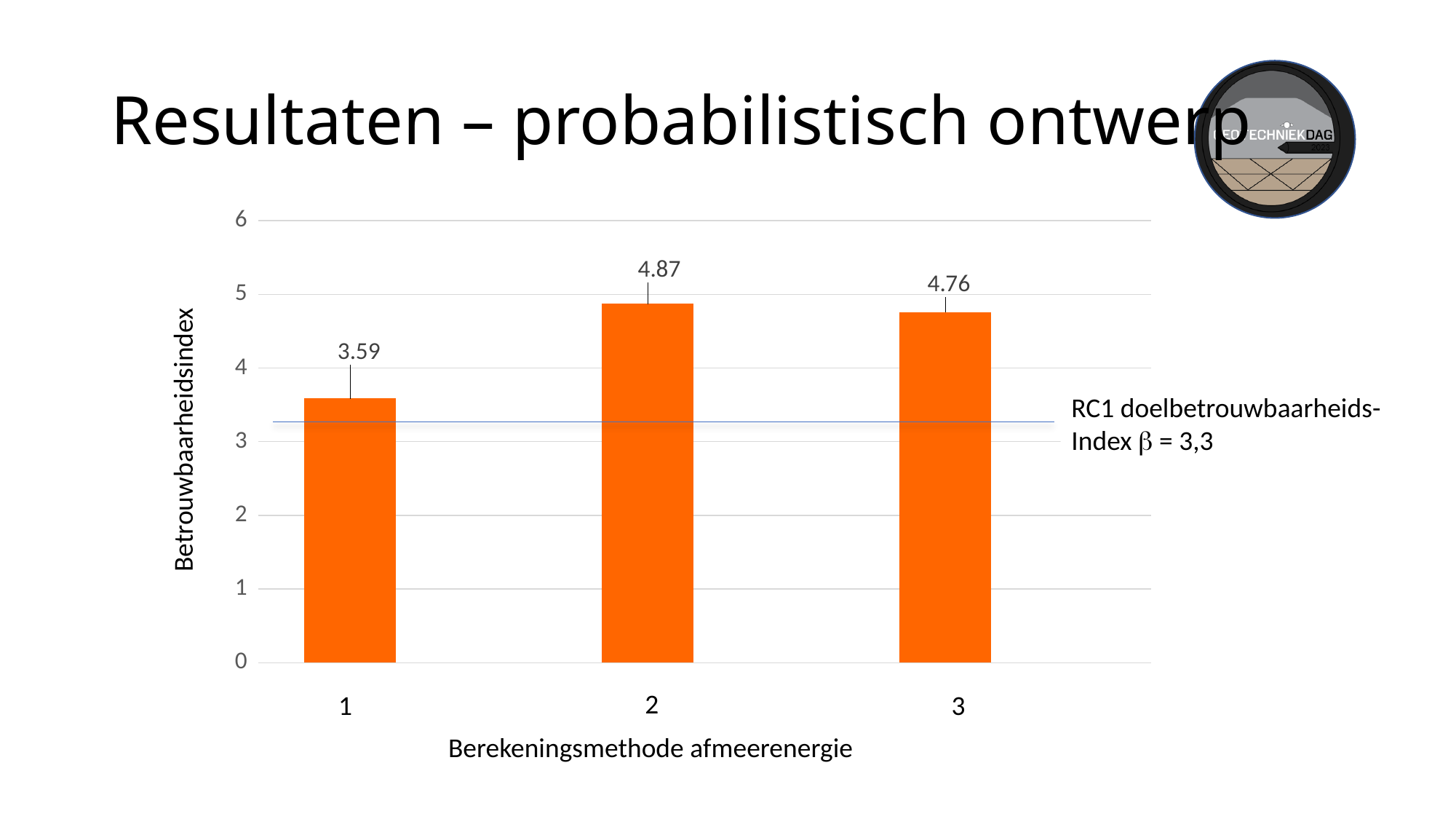
Which has a larger Betrouwbaarheidsindex, method 1 or method 3? 3 What is the difference between the Betrouwbaarheidsindex for method 2 and method 1? 1.28 What is the Betrouwbaarheidsindex for Berekeningsmethode 3? 4.76 How many Berekeningsmethode categories are shown on the x axis? 3 What is the Betrouwbaarheidsindex for Berekeningsmethode 1? 3.59 What is the Betrouwbaarheidsindex for Berekeningsmethode 2? 4.87 Which Berekeningsmethode has the highest Betrouwbaarheidsindex? 2 Which Berekeningsmethode has the lowest Betrouwbaarheidsindex? 1 What is the difference between the Betrouwbaarheidsindex for method 2 and method 3? 0.11 What target value does the horizontal reference line labelled RC1 doelbetrouwbaarheidsindex represent? β = 3,3 Is the value for method 1 greater or less than 4? less What kind of chart is shown on the slide? bar chart